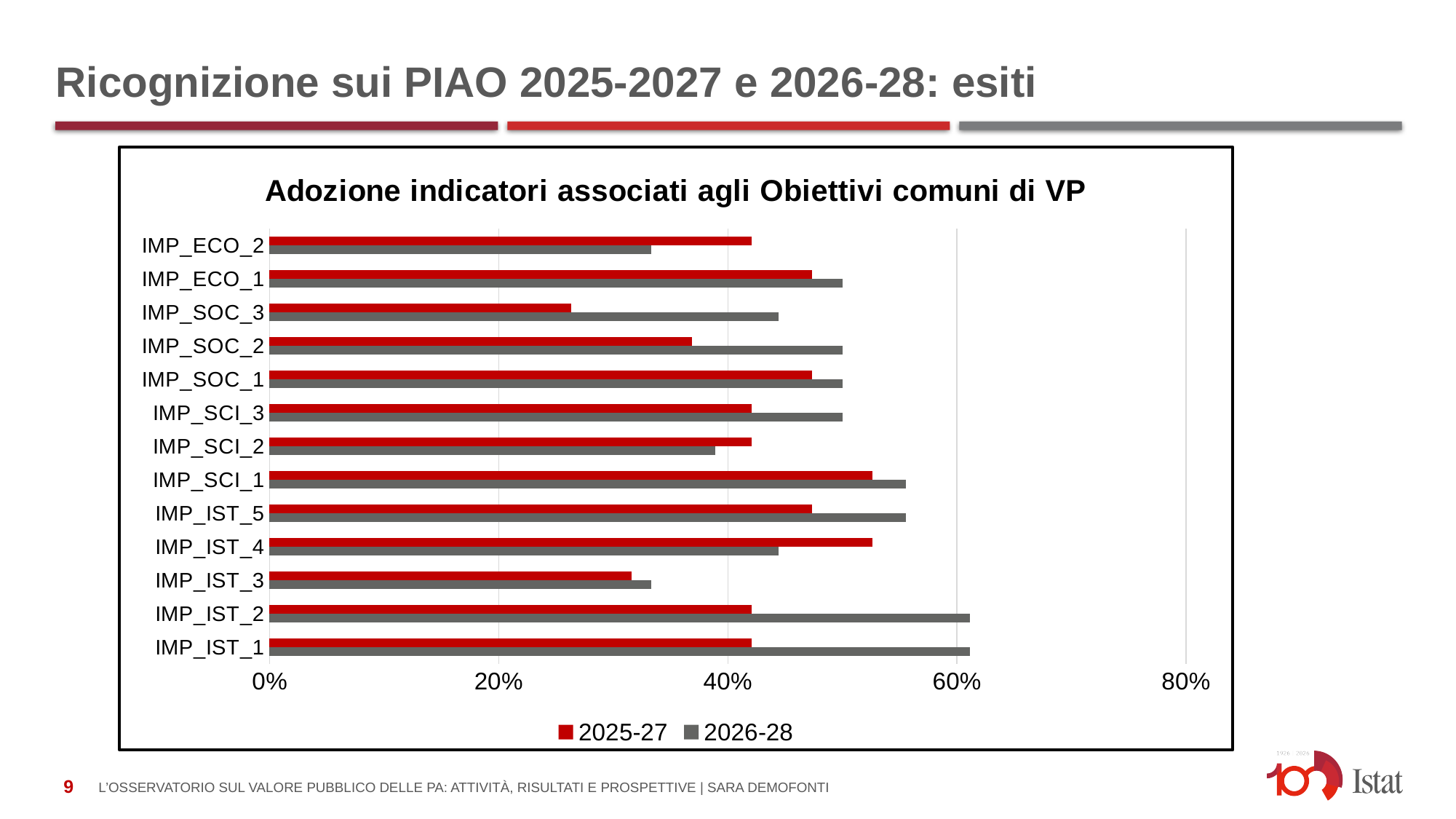
For IMP_SOC_3, which series has the larger value, 2025-27 or 2026-28? 2026-28 Is the 2025-27 value for IMP_SOC_3 greater or less than 20%? greater Is the 2026-28 value for IMP_SCI_1 greater or less than 40%? greater Is the 2025-27 value for IMP_IST_3 greater or less than 40%? less What kind of chart is shown on the slide? Bar chart How many categories are plotted on the vertical axis of the chart? 13 What is the title of the chart? Adozione indicatori associati agli Obiettivi comuni di VP For IMP_IST_2, which series has the larger value, 2025-27 or 2026-28? 2026-28 For IMP_IST_4, which series has the larger value, 2025-27 or 2026-28? 2025-27 Which category has the lowest value for the 2025-27 series? IMP_SOC_3 How many series does the chart legend list? 2 Which series is shown in red in the chart? 2025-27